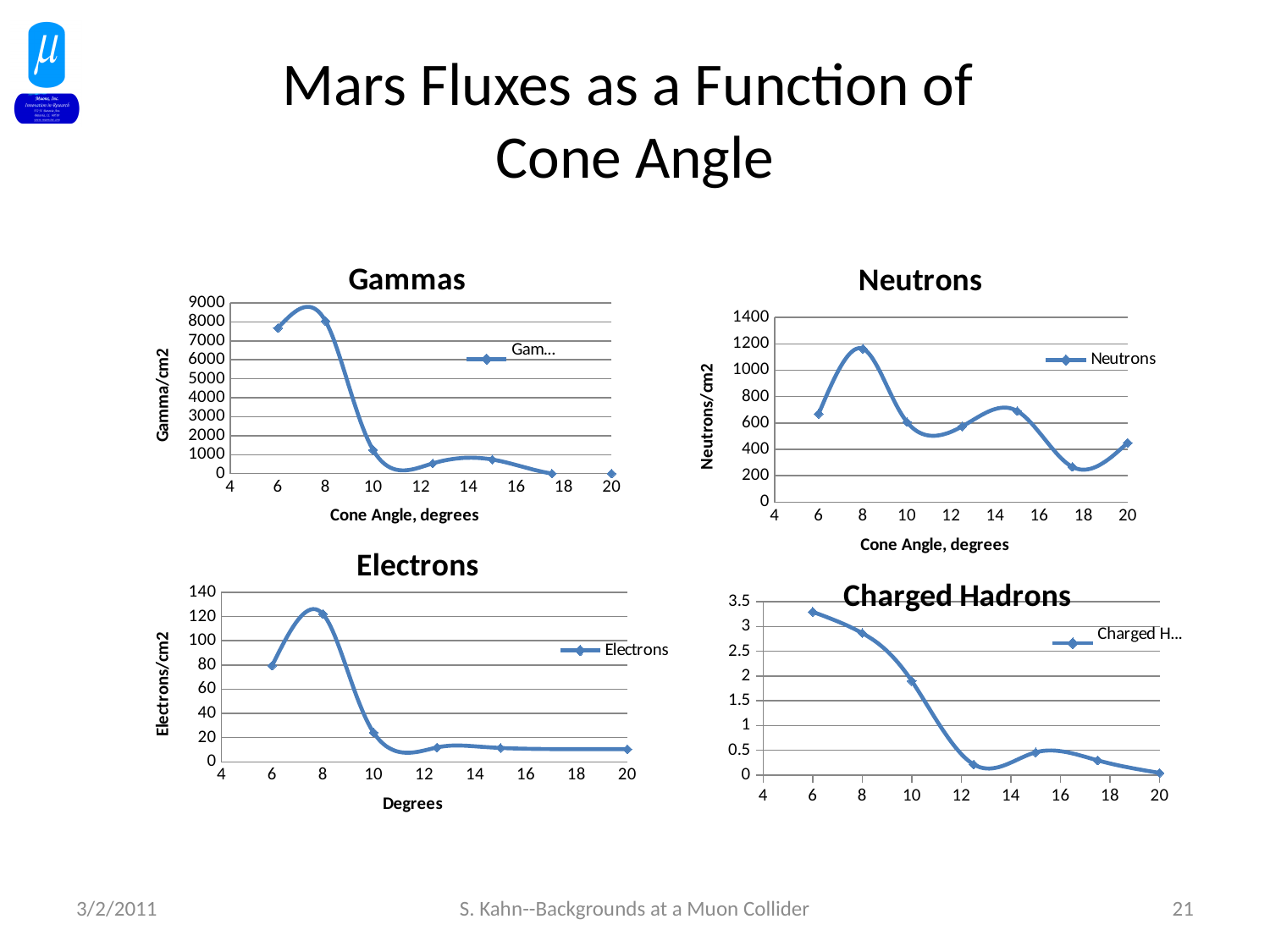
In the Gammas chart, is the value at a cone angle of 6 degrees greater or less than 7000? greater In the Gammas chart, at which cone angle is the gamma flux highest? 8 In the Neutrons chart, at which cone angle is the neutron flux highest? 8 In the Neutrons chart, which is larger: the value at 8 degrees or the value at 20 degrees? 8 degrees What is the y-axis title of the Neutrons chart? Neutrons/cm2 In the Charged Hadrons chart, at which cone angle is the value highest? 6 In the Electrons chart, is the value at 8 degrees greater or less than 100? greater In the Charged Hadrons chart, do the values generally rise or fall as the cone angle increases? fall In the Neutrons chart, is the value at a cone angle of 8 degrees greater or less than 1000? greater What kind of chart is the Gammas chart? line chart